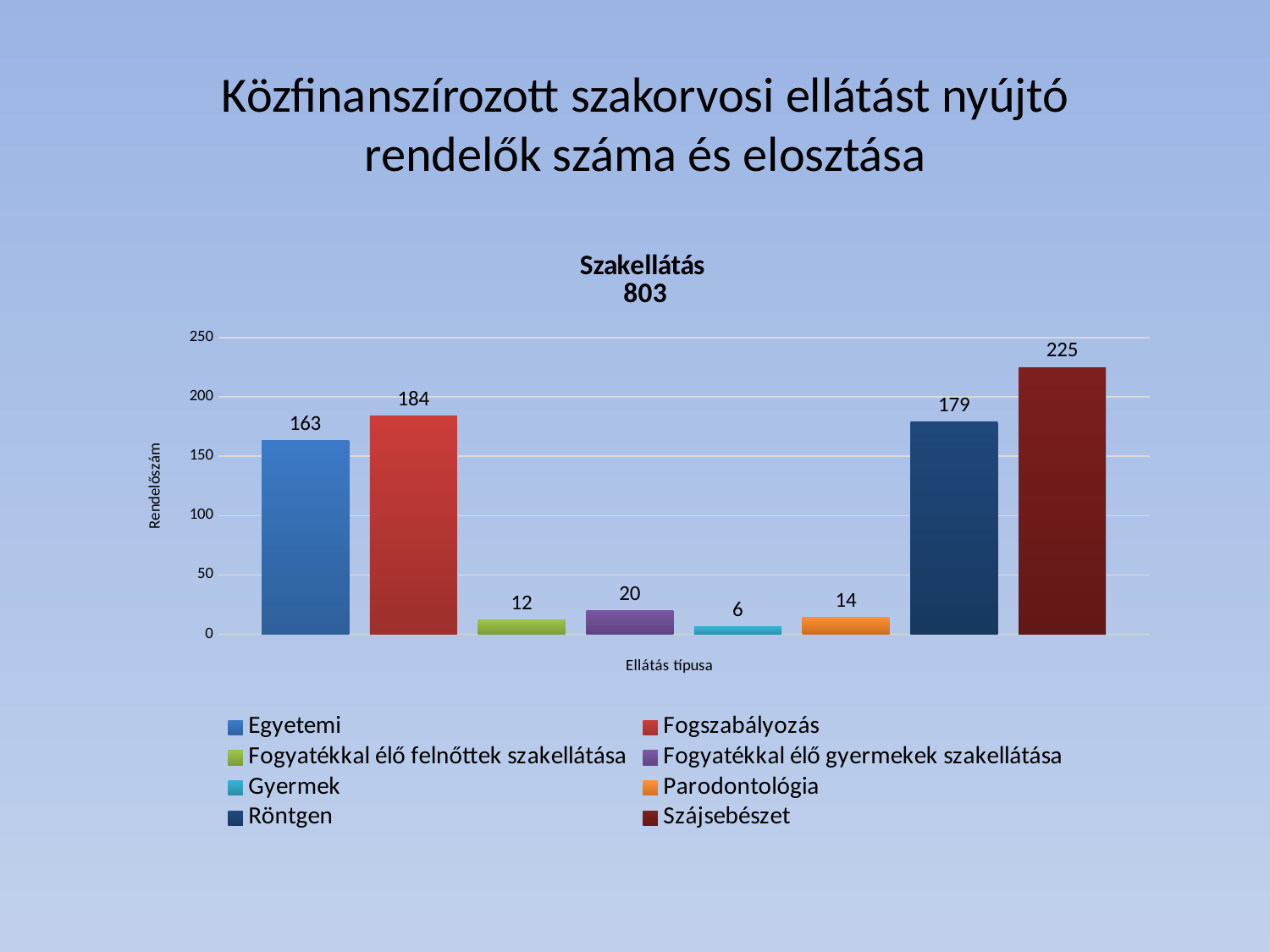
What kind of chart is shown on the slide? Bar chart What is the value for Röntgen? 179 What is the title of the chart? Szakellátás 803 What is the label of the vertical axis? Rendelőszám What is the value for Szájsebészet? 225 Which is larger, the value for Fogyatékkal élő gyermekek szakellátása or the value for Parodontológia? Fogyatékkal élő gyermekek szakellátása How many series does the legend list? 8 Which category has the highest value? Szájsebészet What is the value for Egyetemi? 163 What is the value for Gyermek? 6 Which category has the lowest value? Gyermek What is the difference between the values for Fogszabályozás and Röntgen? 5